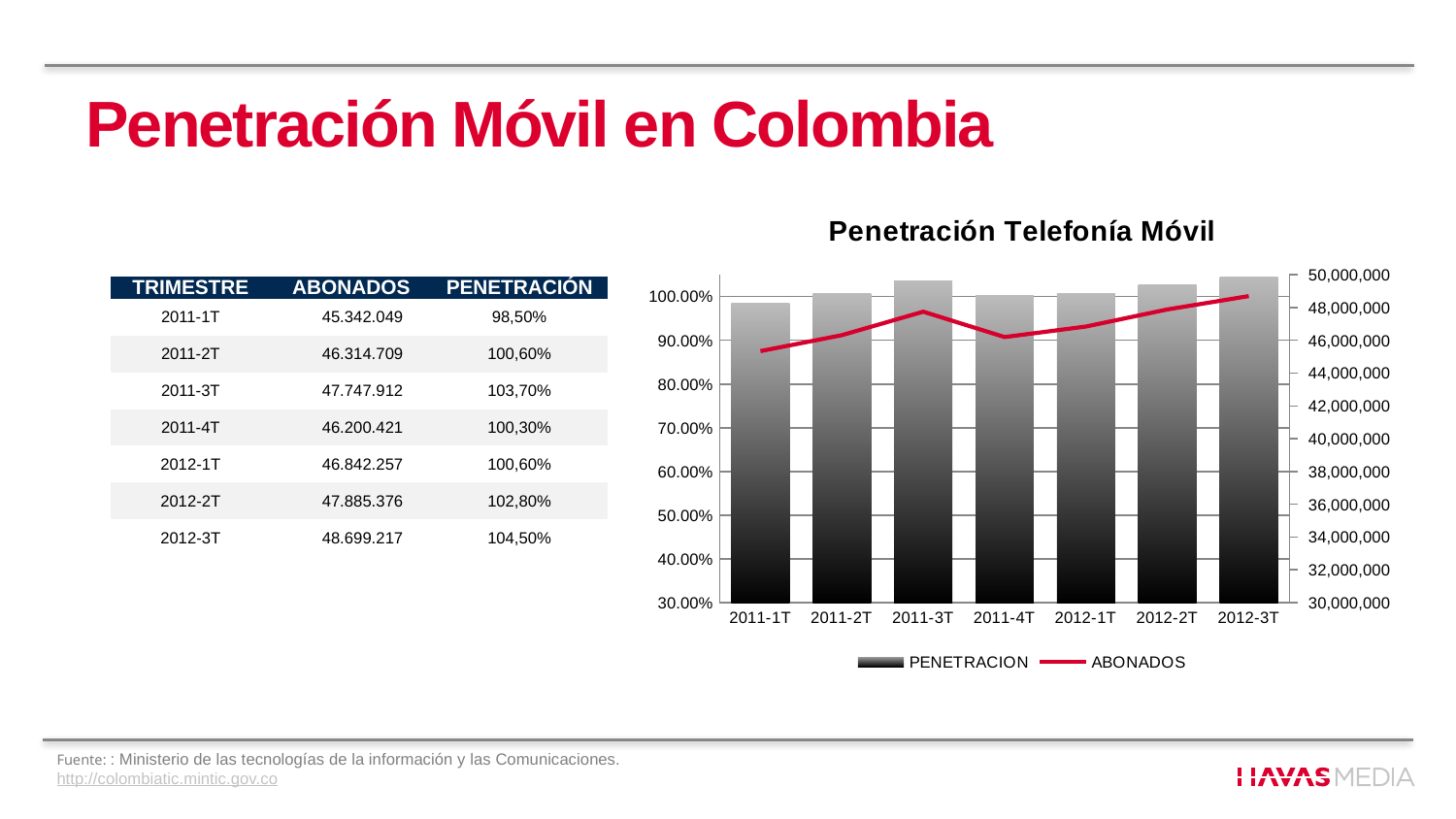
What is the PENETRACIÓN value for 2011-3T? 103,70% How many quarters (categories) are plotted along the x axis of the chart? 7 Is the ABONADOS value for 2011-1T greater or less than 46,000,000? less What kind of chart is shown under the title 'Penetración Telefonía Móvil'? A combined bar and line chart Which series is drawn as a red line in the chart? ABONADOS What is the ABONADOS value for 2012-3T? 48.699.217 Which quarter has the lowest PENETRACIÓN value? 2011-1T Which quarter has the highest PENETRACIÓN value? 2012-3T How many series does the chart legend list? 2 Which is larger, the PENETRACIÓN for 2011-3T or for 2011-4T? 2011-3T Does the ABONADOS line rise or fall from 2011-4T to 2012-3T? rise What is the difference in ABONADOS between 2012-3T and 2011-1T? 3.357.168